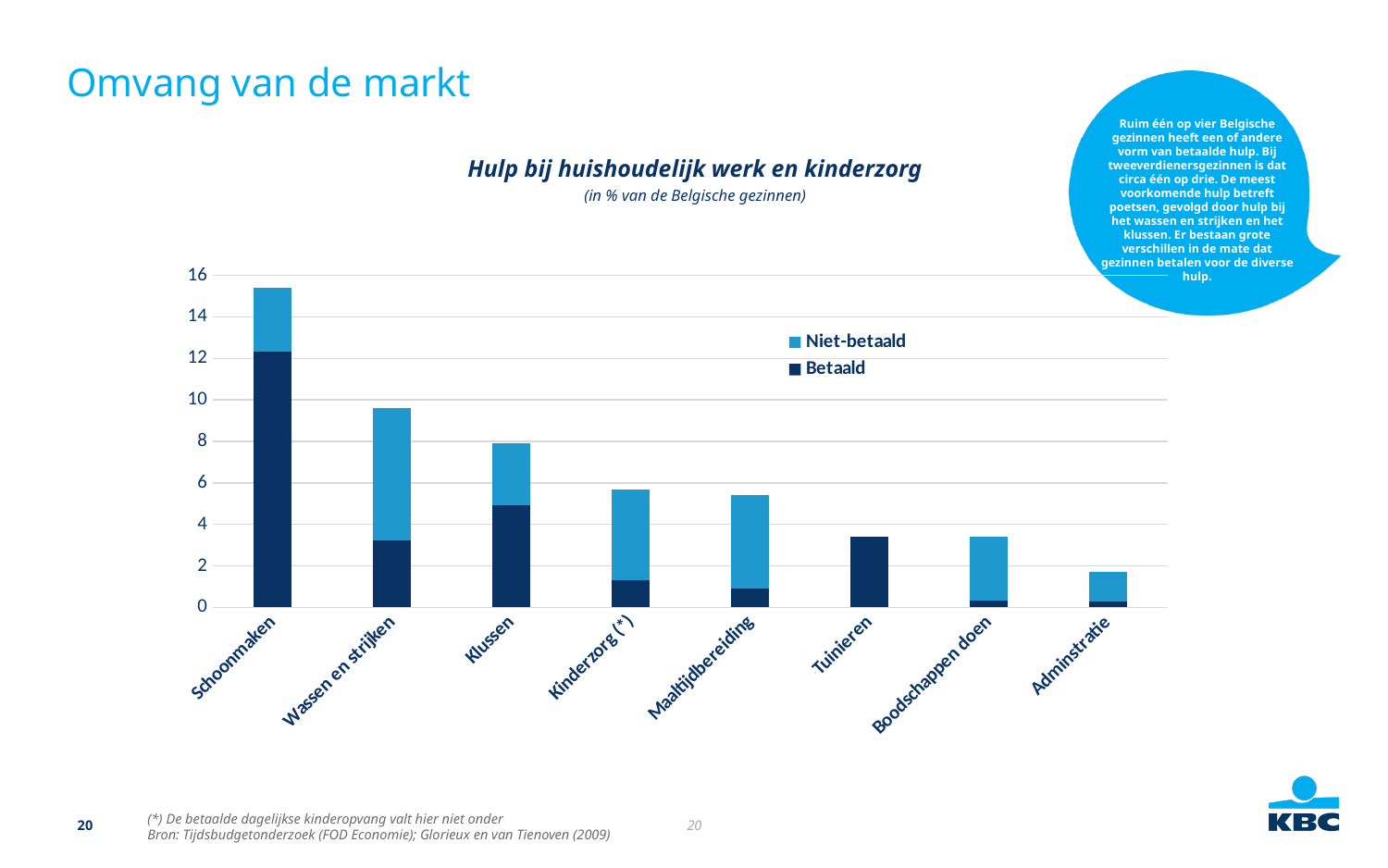
Is the total value for Wassen en strijken greater or less than 8? greater Is the Betaald value for Schoonmaken greater or less than 10? greater Is the total value for Tuinieren greater or less than 4? less Which category has the lowest total bar? Adminstratie Which has the larger Betaald value, Schoonmaken or Wassen en strijken? Schoonmaken Which has the larger total bar, Klussen or Kinderzorg (*)? Klussen How many series does the legend list? 2 How many categories are shown on the x axis of the chart? 8 Which category has the highest total bar? Schoonmaken Do the total bar heights generally rise or fall from left to right along the x axis? fall What kind of chart is shown on the slide? Stacked bar chart